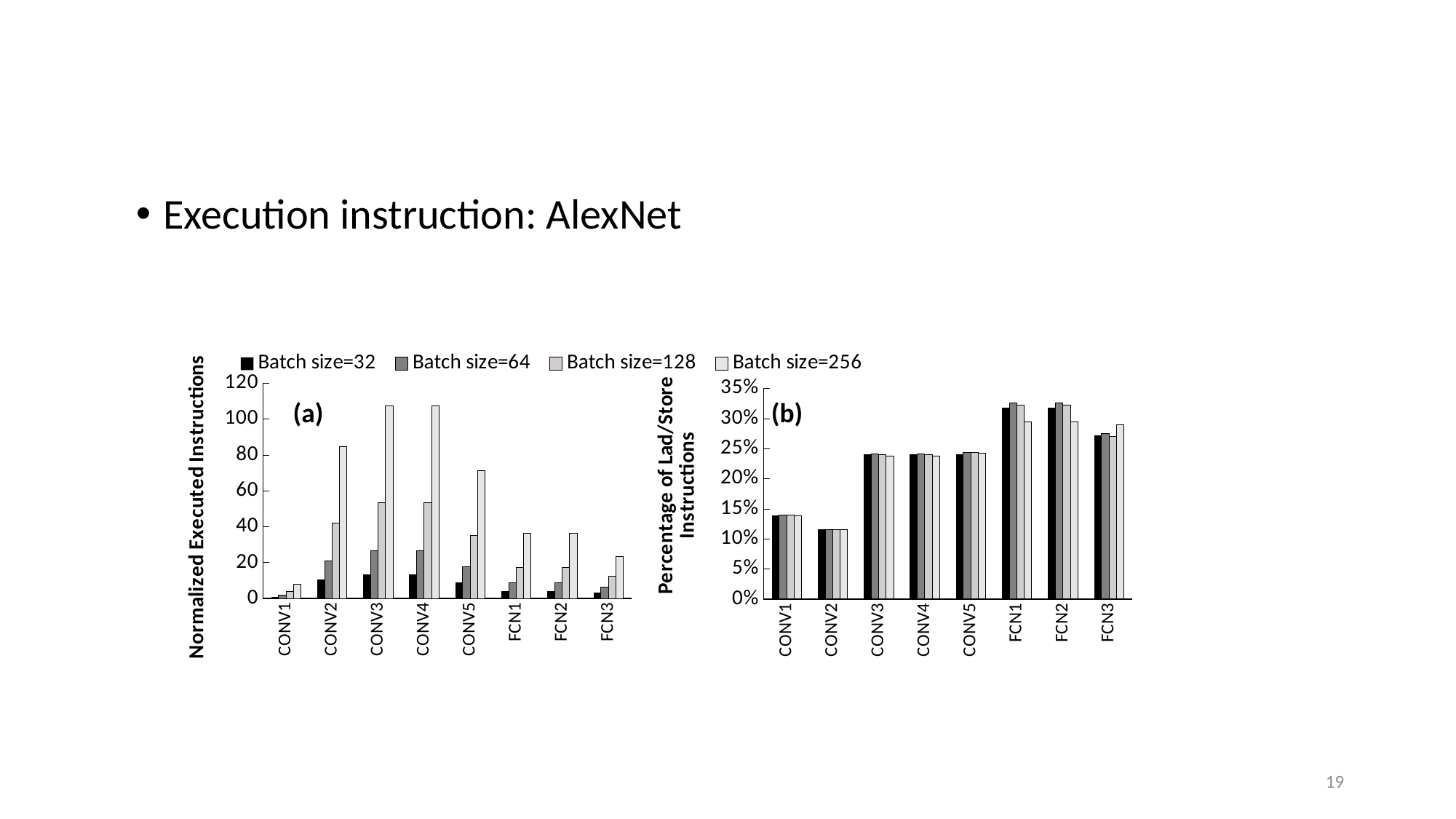
How many series does the legend list for the charts on the slide? 4 In chart (a), Normalized Executed Instructions, is the value for CONV3 at Batch size=256 greater or less than 100? greater What is the y-axis title of chart (a), the left chart? Normalized Executed Instructions In chart (b), Percentage of Load/Store Instructions, which category has the lowest value for Batch size=32? CONV2 In chart (b), Percentage of Load/Store Instructions, which is larger for Batch size=256: FCN3 or CONV5? FCN3 In chart (a), Normalized Executed Instructions, do the Batch size=256 values rise or fall from CONV1 to CONV3? rise In chart (a), Normalized Executed Instructions, is the value for FCN1 at Batch size=256 greater or less than 40? less What kind of chart is chart (a), Normalized Executed Instructions? bar chart In chart (b), Percentage of Load/Store Instructions, is the value for FCN1 at Batch size=32 greater or less than 30%? greater How many categories are shown on the x axis of chart (b), Percentage of Load/Store Instructions? 8 In chart (a), Normalized Executed Instructions, which category has the lowest value for Batch size=256? CONV1 In chart (a), Normalized Executed Instructions, which is larger for Batch size=256: CONV2 or CONV5? CONV2